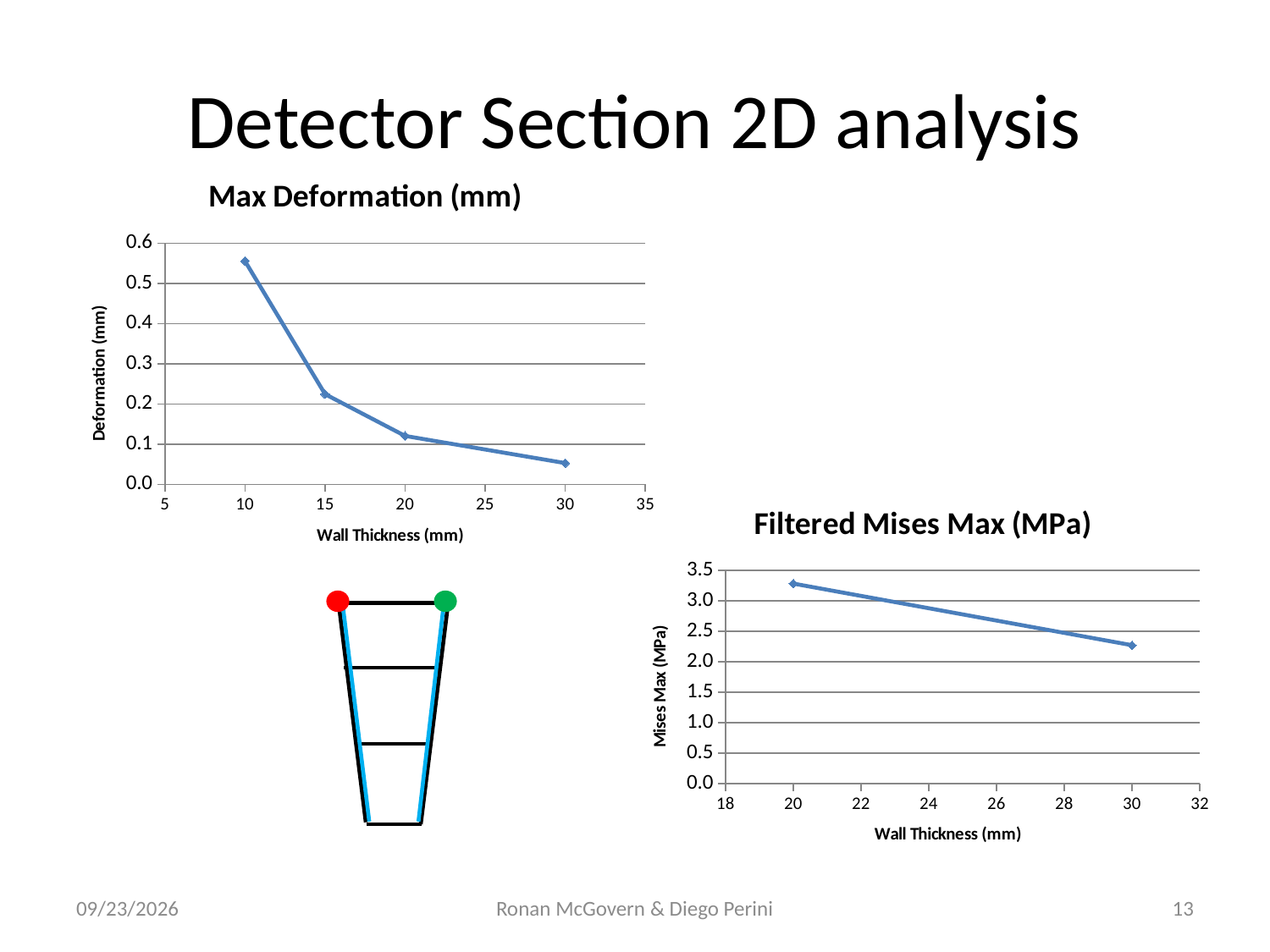
In the "Max Deformation (mm)" chart, does the deformation rise or fall as wall thickness increases? fall What kind of chart is the "Max Deformation (mm)" chart? line chart In the "Filtered Mises Max (MPa)" chart, how many data points are plotted? 2 What is the x-axis label of the "Filtered Mises Max (MPa)" chart? Wall Thickness (mm) In the "Max Deformation (mm)" chart, is the deformation at a wall thickness of 30 mm greater or less than 0.1? less In the "Filtered Mises Max (MPa)" chart, which wall thickness has the larger Mises Max value, 20 mm or 30 mm? 20 mm In the "Max Deformation (mm)" chart, at which wall thickness is the deformation highest? 10 In the "Max Deformation (mm)" chart, is the deformation at a wall thickness of 15 mm greater or less than 0.3? less In the "Max Deformation (mm)" chart, how many data points are plotted? 4 In the "Max Deformation (mm)" chart, at which wall thickness is the deformation lowest? 30 In the "Filtered Mises Max (MPa)" chart, is the value at a wall thickness of 20 mm greater or less than 3.0? greater